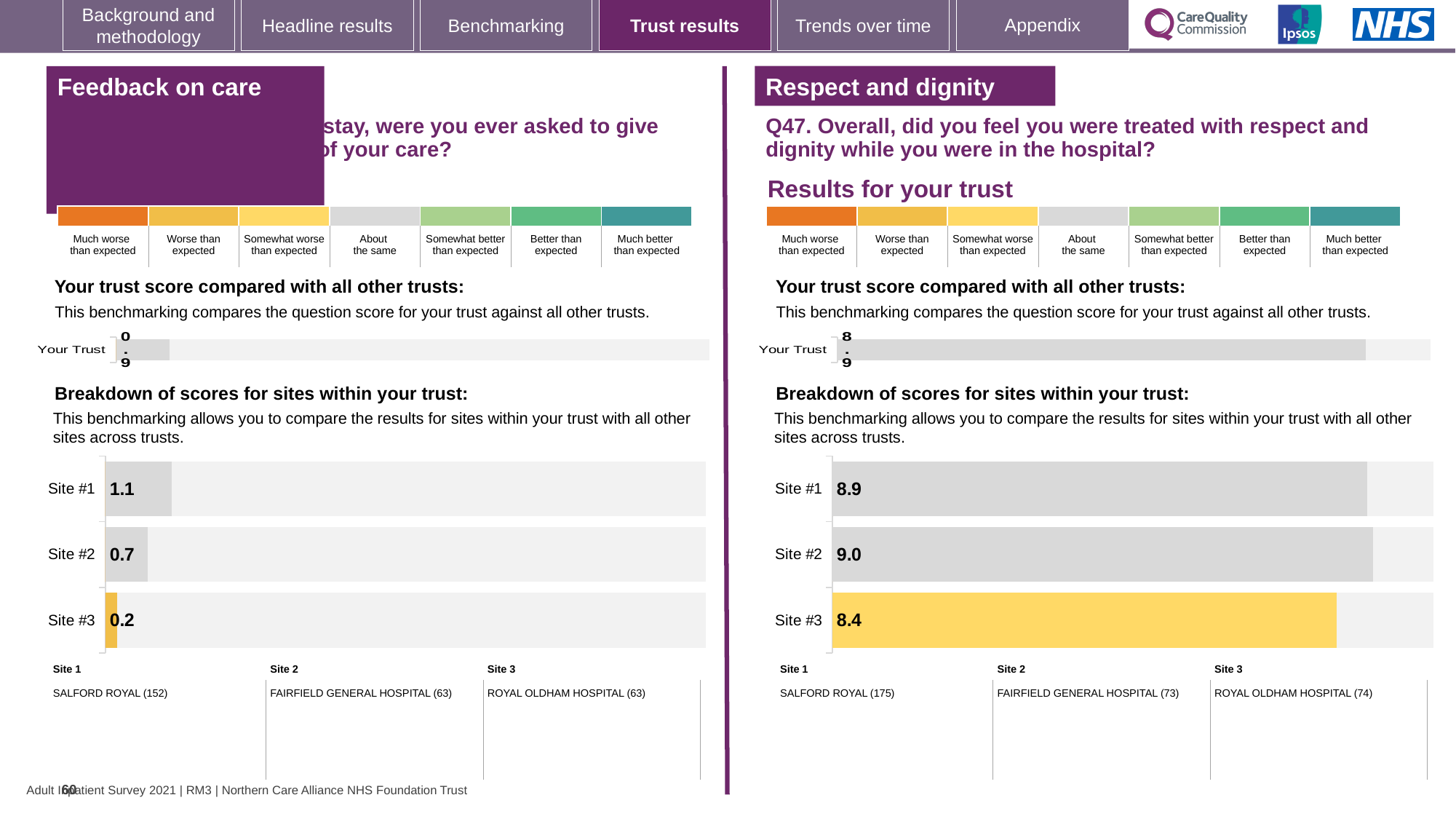
In the 'Feedback on care' site breakdown chart, what is the difference between the scores for Site #1 and Site #2? 0.4 In the 'Respect and dignity' site breakdown chart, what is the score for Site #2? 9.0 In the 'Respect and dignity' site breakdown chart, what is the difference between the scores for Site #2 and Site #3? 0.6 In the 'Respect and dignity' site breakdown chart, which site has the highest score? Site #2 In the 'Feedback on care' panel, what is the 'Your Trust' score? 0.9 In the 'Respect and dignity' panel, what is the 'Your Trust' score? 8.9 What type of chart is used for the site breakdown in the 'Feedback on care' panel? Bar chart In the 'Feedback on care' site breakdown chart, what is the score for Site #3? 0.2 How many sites are shown in the 'Respect and dignity' site breakdown chart? 3 In the 'Feedback on care' site breakdown chart, what is the score for Site #1? 1.1 In the 'Respect and dignity' site breakdown chart, what is the score for Site #3? 8.4 In the 'Feedback on care' site breakdown chart, which site has the lowest score? Site #3